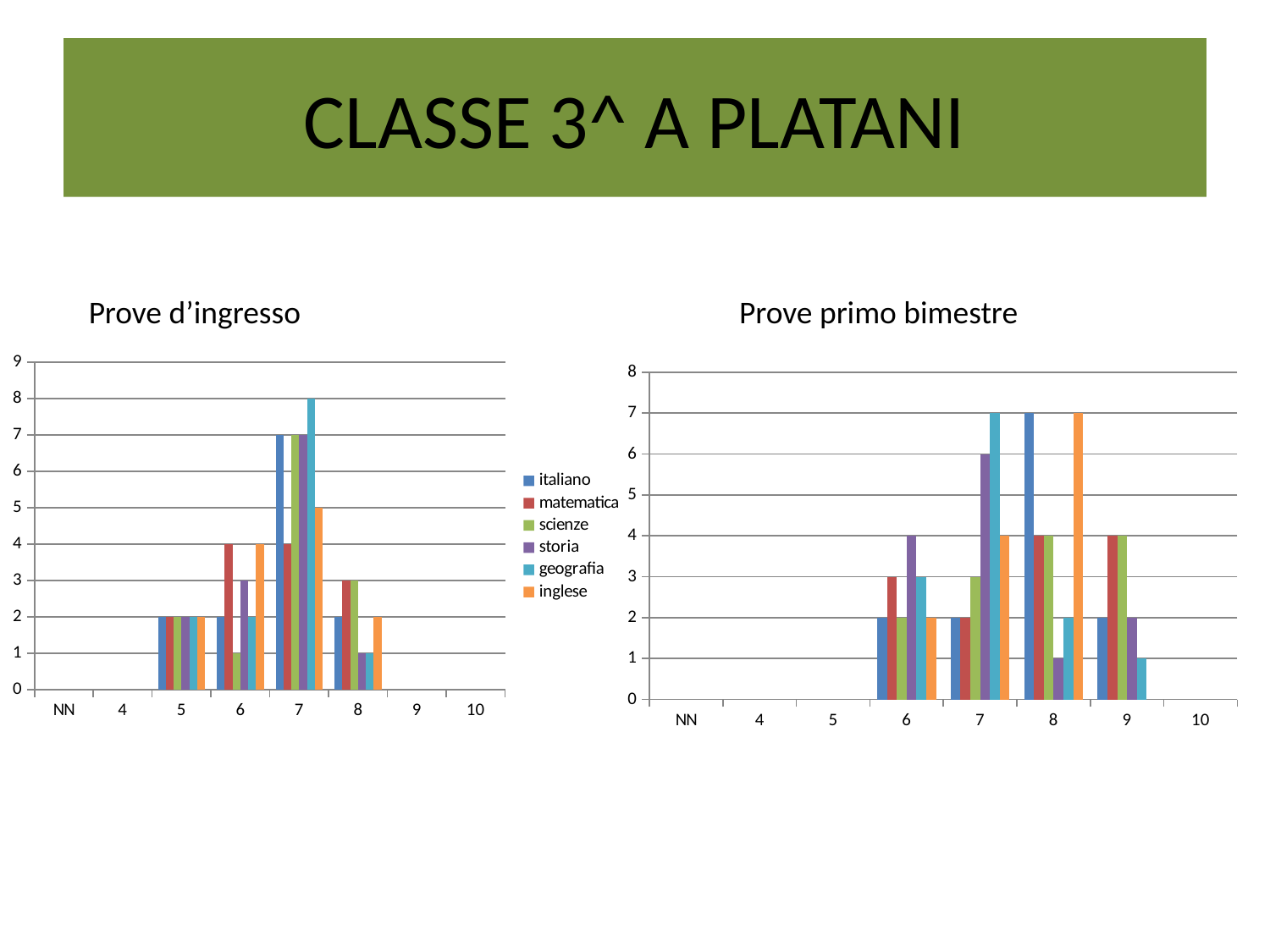
In the "Prove primo bimestre" chart, which series has the lowest value at category 9? geografia How many categories are shown on the x axis of the "Prove primo bimestre" chart? 8 In the "Prove primo bimestre" chart, what is the difference between geografia and italiano at category 7? 5 In the "Prove d'ingresso" chart, which series has the highest value at category 7? geografia In the "Prove d'ingresso" chart, what is the value for geografia at category 7? 8 In the "Prove primo bimestre" chart, which is larger at category 8: matematica or storia? matematica In the "Prove primo bimestre" chart, what is the value for italiano at category 8? 7 In the "Prove primo bimestre" chart, what is the value for storia at category 7? 6 In the "Prove d'ingresso" chart, what is the value for matematica at category 6? 4 How many series does the legend list? 6 In the "Prove d'ingresso" chart, which series has the lowest value at category 6? scienze What type of chart is the "Prove d'ingresso" chart? bar chart